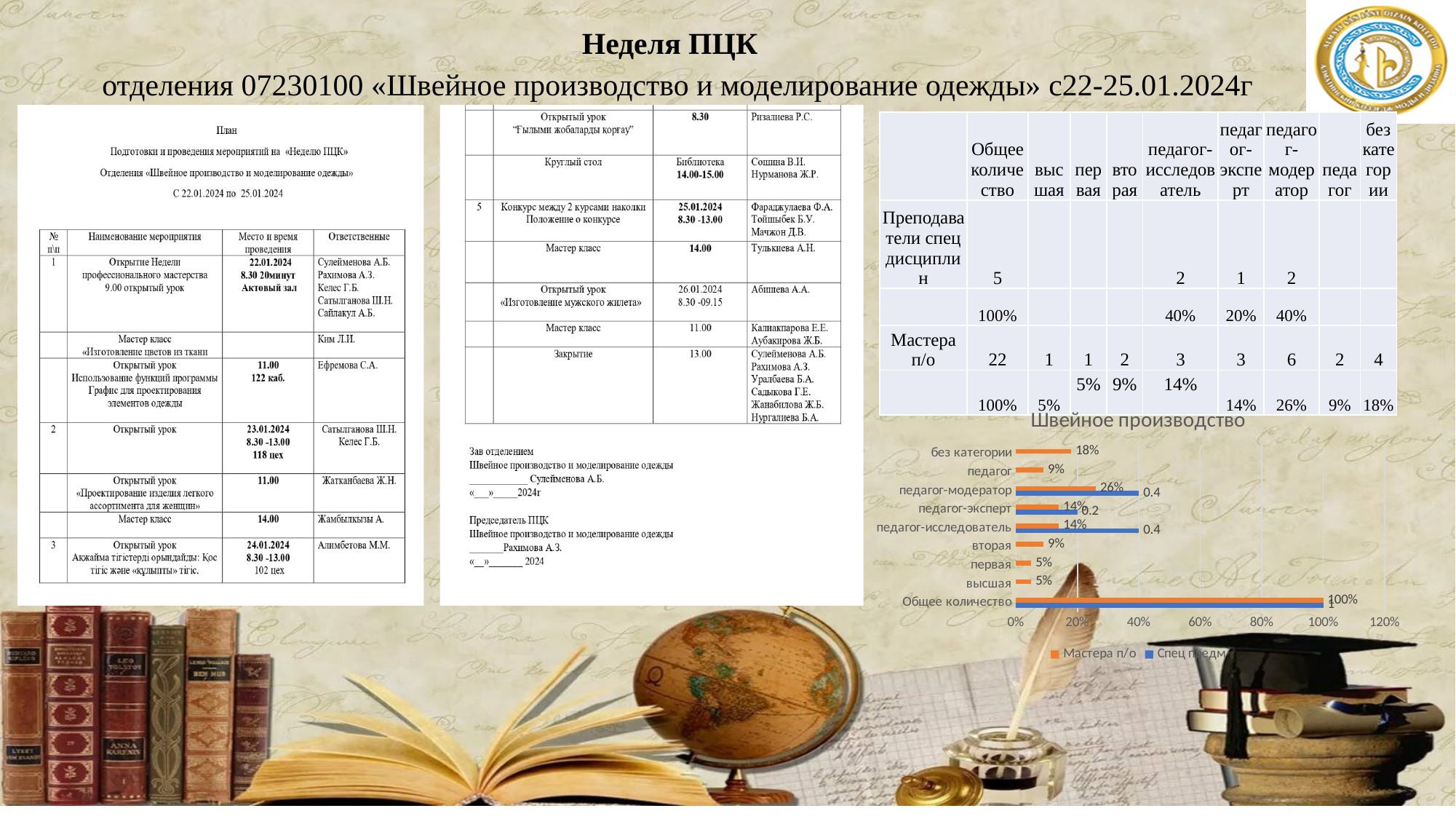
What kind of chart is shown under the title "Швейное производство"? bar chart In the "Швейное производство" chart, excluding "Общее количество", which category has the highest value in the "Мастера п/о" series? педагог-модератор In the "Швейное производство" chart, what is the value for "педагог-исследователь" in the blue series? 0.4 In the "Швейное производство" chart, what is the difference between the "Мастера п/о" values for "педагог-модератор" and "без категории"? 8% In the "Швейное производство" chart, what is the value for "высшая" in the "Мастера п/о" series? 5% In the "Швейное производство" chart, what is the value for "педагог-эксперт" in the "Мастера п/о" series? 14% In the "Швейное производство" chart, which is larger in the "Мастера п/о" series: "педагог" or "педагог-эксперт"? педагог-эксперт In the "Швейное производство" chart, what is the value for "педагог-модератор" in the "Мастера п/о" series? 26% In the "Швейное производство" chart, what is the value for "педагог-эксперт" in the blue series? 0.2 In the "Швейное производство" chart, what is the value for "без категории" in the "Мастера п/о" series? 18% How many categories are listed on the vertical axis of the "Швейное производство" chart? 9 How many series does the legend of the "Швейное производство" chart list? 2